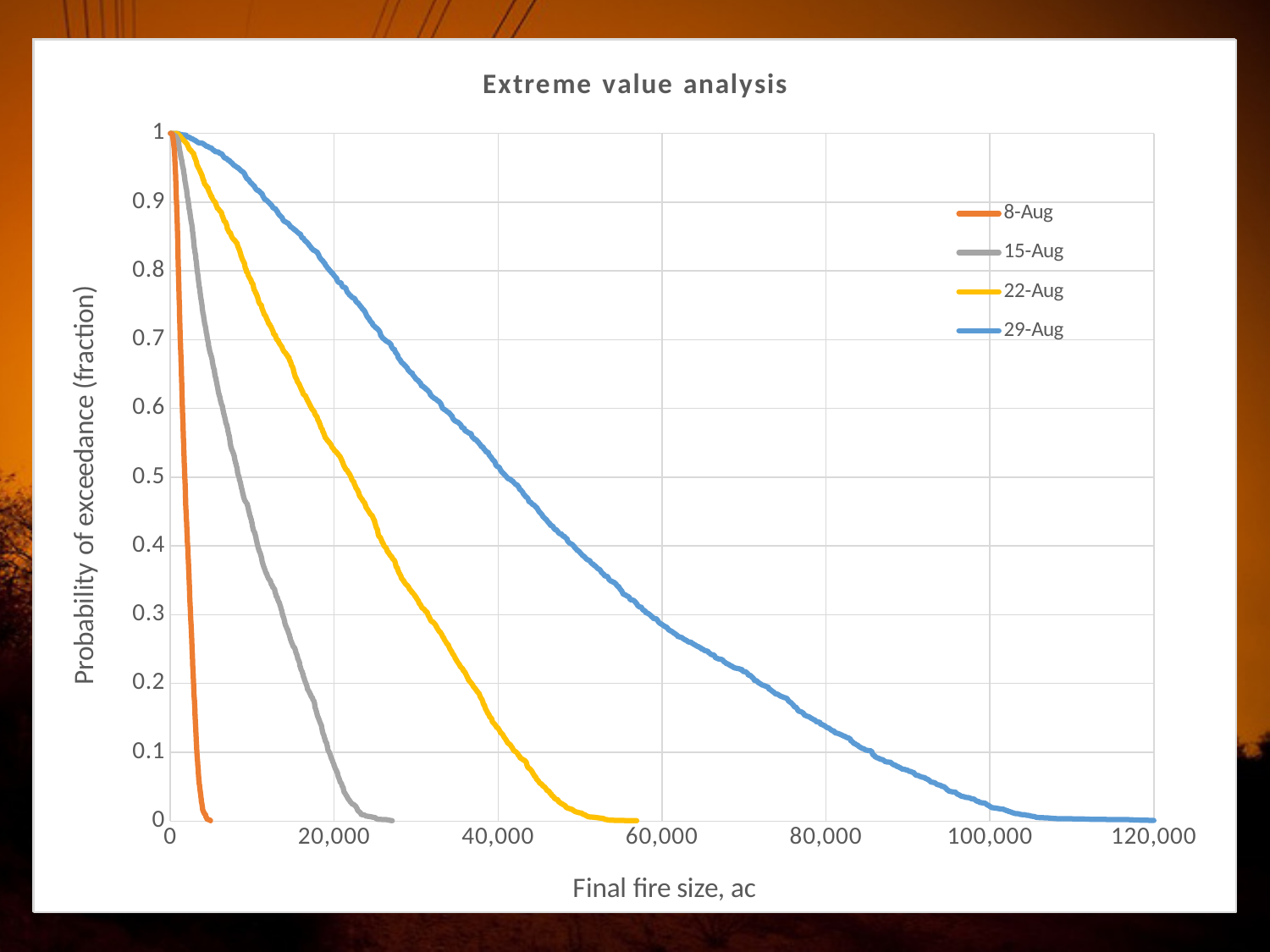
Which series reaches a probability of exceedance of 0 at the smallest final fire size? 8-Aug Is the probability of exceedance for 22-Aug at a final fire size of 40,000 ac greater or less than 0.3? less At a final fire size of 40,000 ac, which series has the higher probability of exceedance, 29-Aug or 22-Aug? 29-Aug Is the probability of exceedance for 15-Aug at a final fire size of 20,000 ac greater or less than 0.2? less What kind of chart is shown on the slide? Line chart Is the probability of exceedance for 29-Aug at a final fire size of 40,000 ac greater or less than 0.6? less Which series extends to the largest final fire size before reaching a probability of 0? 29-Aug How many series does the legend list? 4 What is the label of the vertical axis? Probability of exceedance (fraction) Do the values of the 29-Aug series rise or fall as final fire size increases? Fall What is the title of the chart? Extreme value analysis